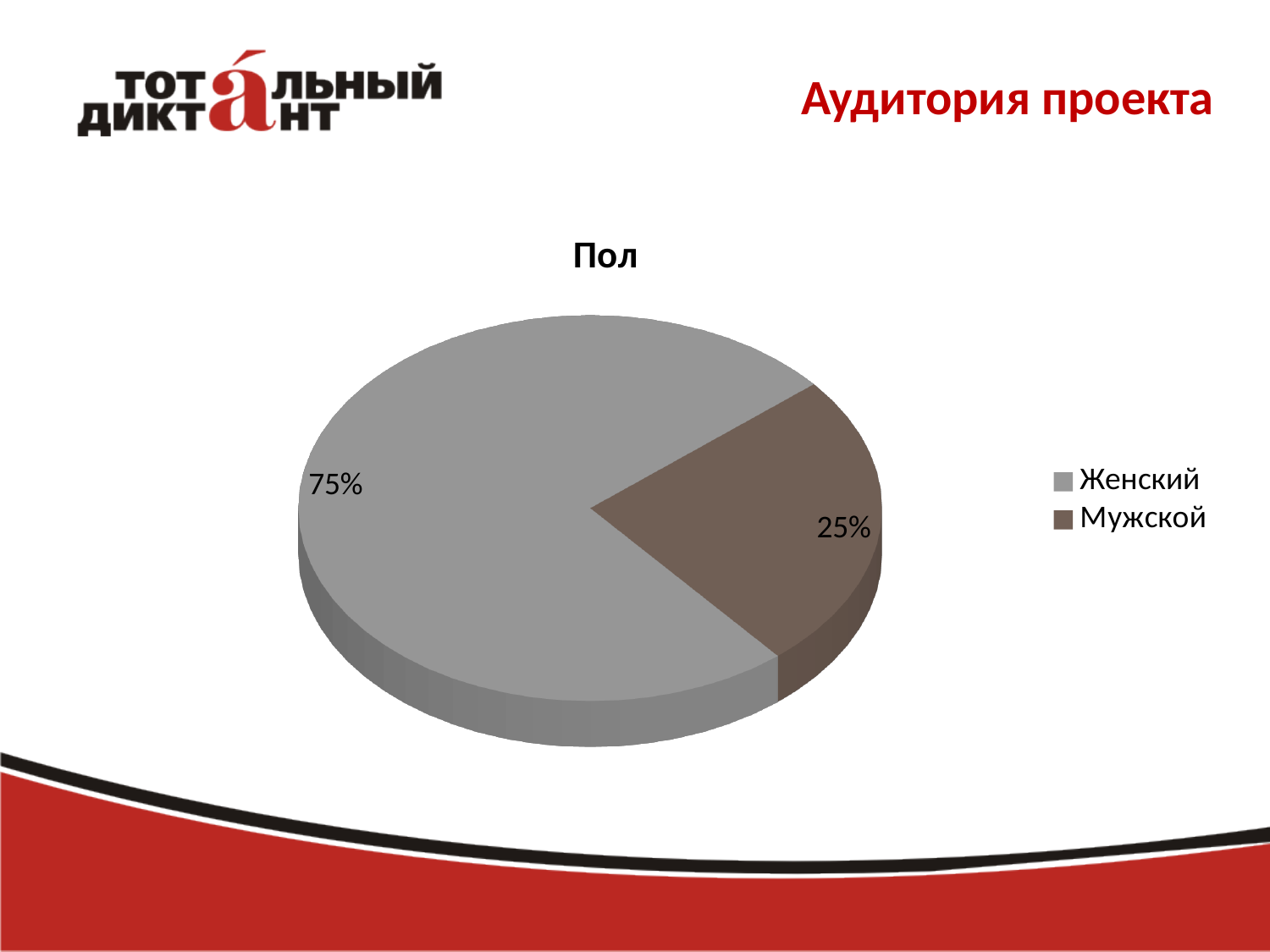
What is the title of the chart? Пол How many entries does the legend list? 2 Which category has the smallest slice of the pie? Мужской What share of the pie does Женский represent? 75% Which category has the largest slice of the pie? Женский What type of chart is shown on the slide? Pie chart What is the difference in percentage points between the Женский and Мужской slices? 50 What colour is the Мужской slice? Brown Which is larger, the Женский slice or the Мужской slice? Женский How many categories does the pie chart have? 2 What share of the pie does Мужской represent? 25%